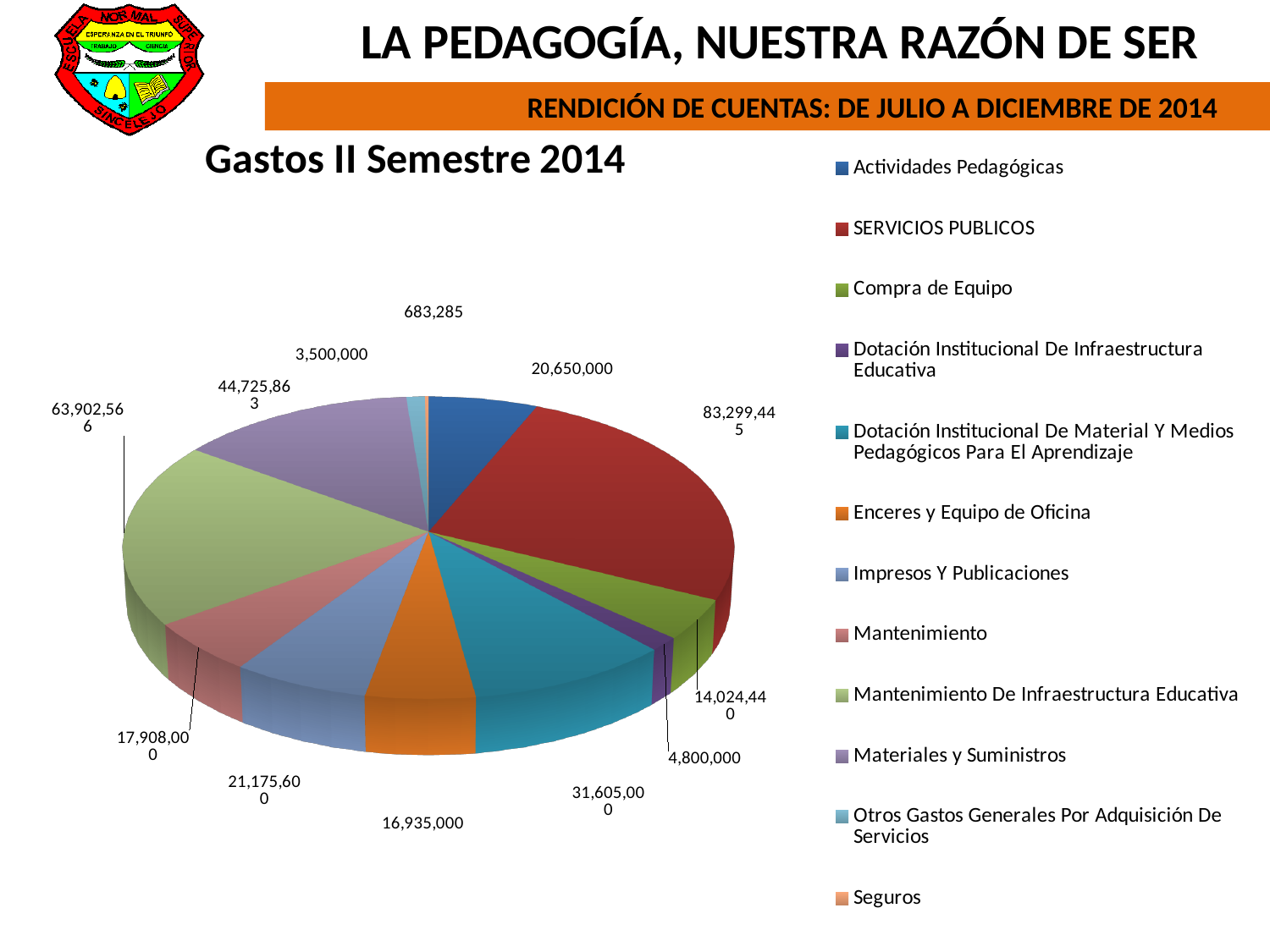
Which category has the smallest slice of the pie? Seguros What is the title of the chart? Gastos II Semestre 2014 Which is larger, the value for Impresos Y Publicaciones or the value for Mantenimiento? Impresos Y Publicaciones What is the difference between the values for SERVICIOS PUBLICOS and Mantenimiento De Infraestructura Educativa? 19,396,879 What is the value for SERVICIOS PUBLICOS? 83,299,445 How many categories does the legend of the pie chart list? 12 What colour is the slice for Enceres y Equipo de Oficina? Orange What is the value for Actividades Pedagógicas? 20,650,000 What type of chart is shown on the slide? Pie chart Which category has the largest slice of the pie? SERVICIOS PUBLICOS What is the value for Seguros? 683,285 What is the value for Materiales y Suministros? 44,725,863